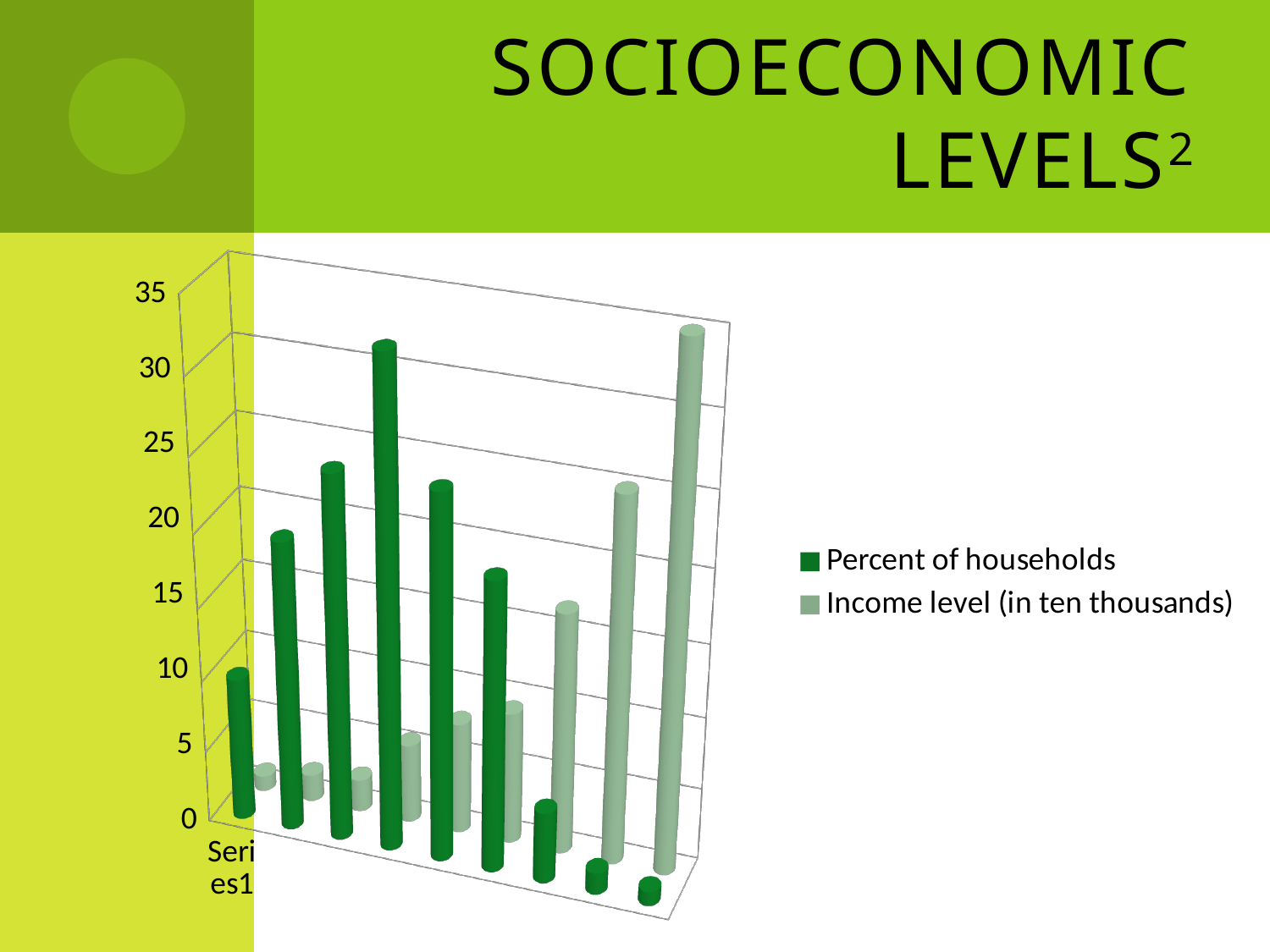
How many categories (groups of bars) are plotted on the chart? 9 In the last category, which series has the larger value? Income level (in ten thousands) For the Percent of households series, which category has the shortest bar? the last (ninth) category What kind of chart is shown on the slide? bar chart Do the Income level (in ten thousands) bars generally rise or fall from left to right? rise What are the two series named in the legend? Percent of households; Income level (in ten thousands) How many series does the legend list? 2 For the Income level (in ten thousands) series, which category has the tallest bar? the last (ninth) category In the first category (Series1), which series has the larger value? Percent of households For the Percent of households series, which category has the tallest bar? the fourth category from the left Is the Income level (in ten thousands) value for the last category greater or less than 25? greater Is the Percent of households value for the first category (Series1) greater or less than 15? less